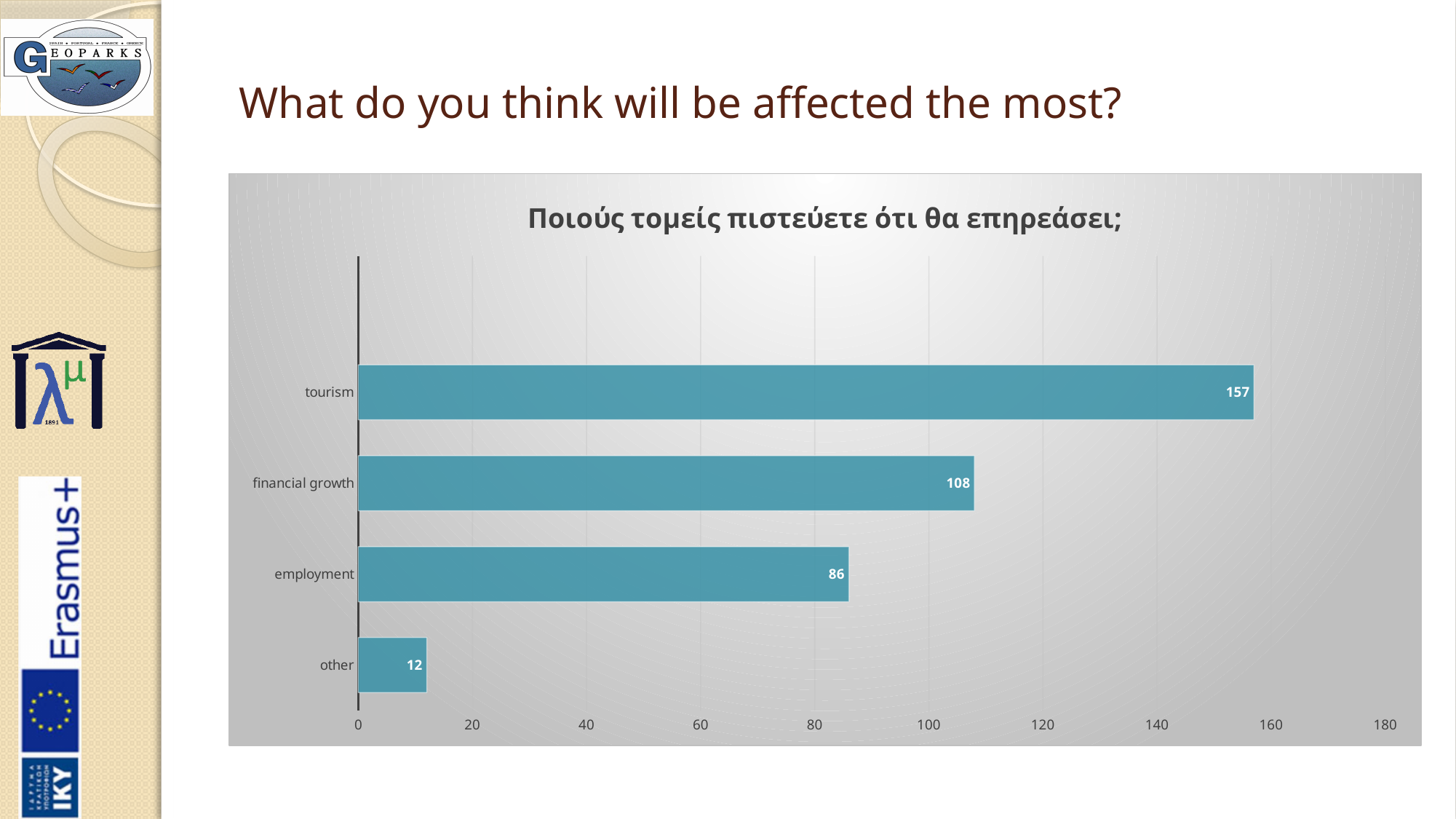
What kind of chart is shown on the slide? bar chart What is the difference between the values for financial growth and employment? 22 Which is larger, the value for employment or the value for other? employment What is the value for other? 12 Which category has the highest value? tourism How many categories are shown in the chart? 4 Is the value for tourism greater or less than 140? greater Which category has the lowest value? other What is the value for employment? 86 What is the difference between the values for tourism and financial growth? 49 What is the value for financial growth? 108 What is the value for tourism? 157